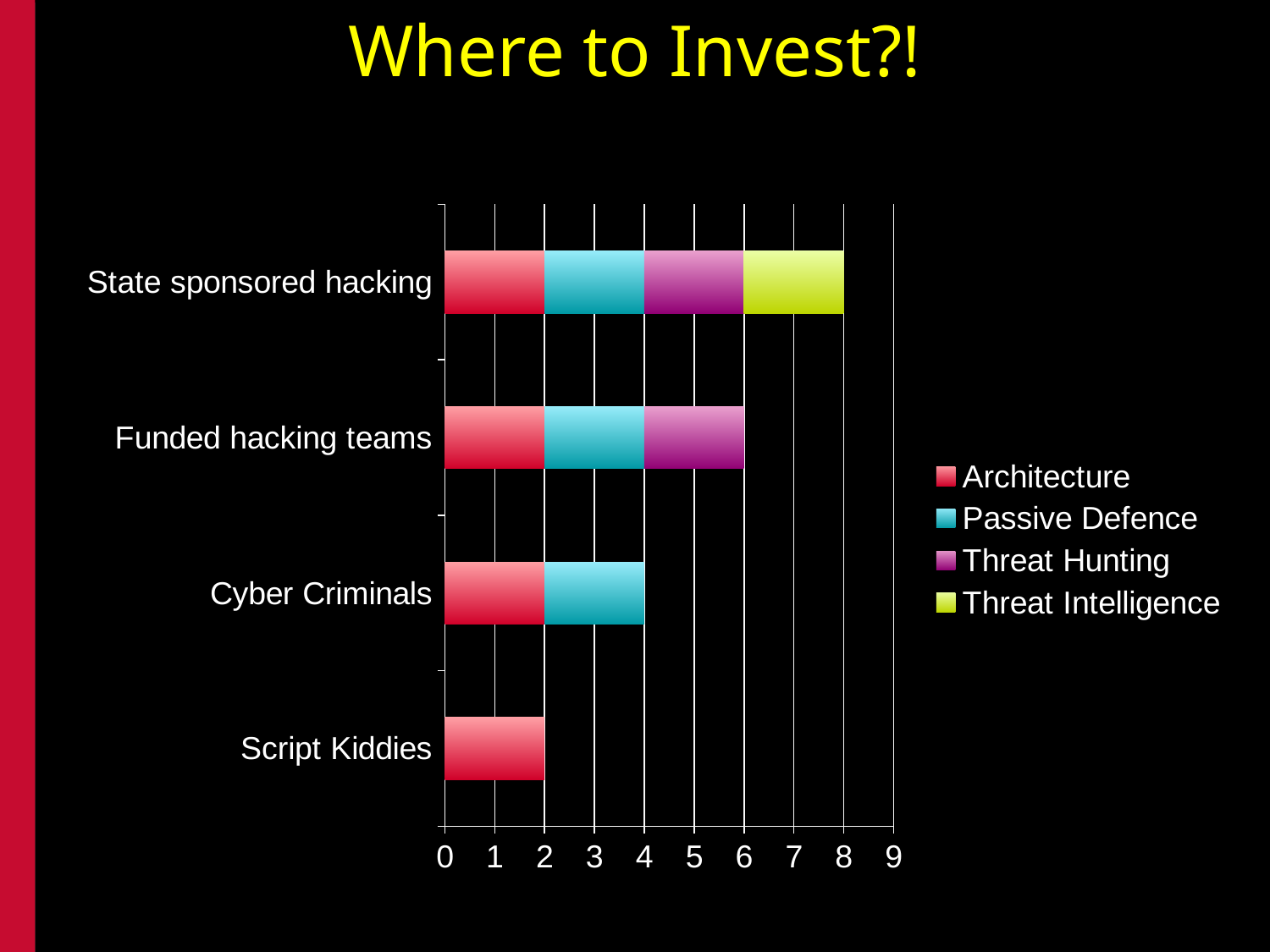
Which series is shown in yellow-green in the legend? Threat Intelligence What is the value of the Architecture segment for Script Kiddies? 2 What is the difference between the total bar for State sponsored hacking and the total bar for Script Kiddies? 6 Which category has the shortest total bar? Script Kiddies What is the total of the stacked bar for Funded hacking teams? 6 What is the total of the stacked bar for Cyber Criminals? 4 How many series does the legend list? 4 How many categories are shown on the chart? 4 Which category has a larger total bar, Funded hacking teams or Cyber Criminals? Funded hacking teams What kind of chart is shown on the slide? Stacked bar chart Which category has the longest total bar? State sponsored hacking What is the total of the stacked bar for State sponsored hacking? 8